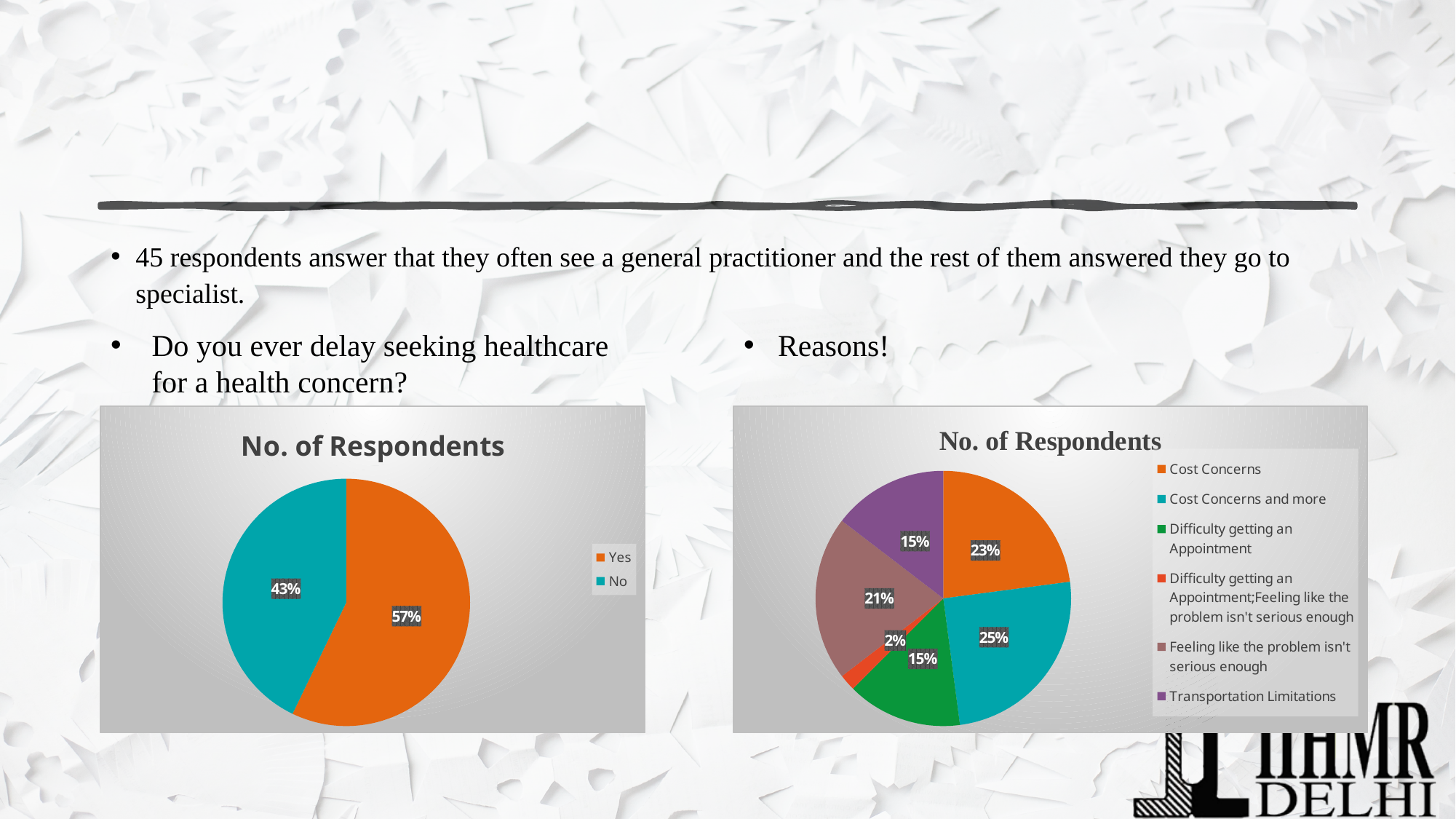
In the right pie chart, what share is labelled for Transportation Limitations? 15% In the right pie chart, what is the difference in percentage points between Feeling like the problem isn't serious enough and Cost Concerns? 2 In the right pie chart, which colour represents Cost Concerns? Orange What kind of chart is the left chart? Pie chart In the left pie chart, what share of respondents answered Yes? 57% In the right pie chart, what share is labelled for Cost Concerns and more? 25% In the right pie chart, which reason has the smallest share? Difficulty getting an Appointment;Feeling like the problem isn't serious enough In the left pie chart, what is the difference in percentage points between the Yes and No shares? 14 In the left pie chart, which answer has the larger share, Yes or No? Yes In the right pie chart, which reason has the largest share? Cost Concerns and more In the right pie chart, how many reasons are listed in the legend? 6 In the left pie chart, what share of respondents answered No? 43%